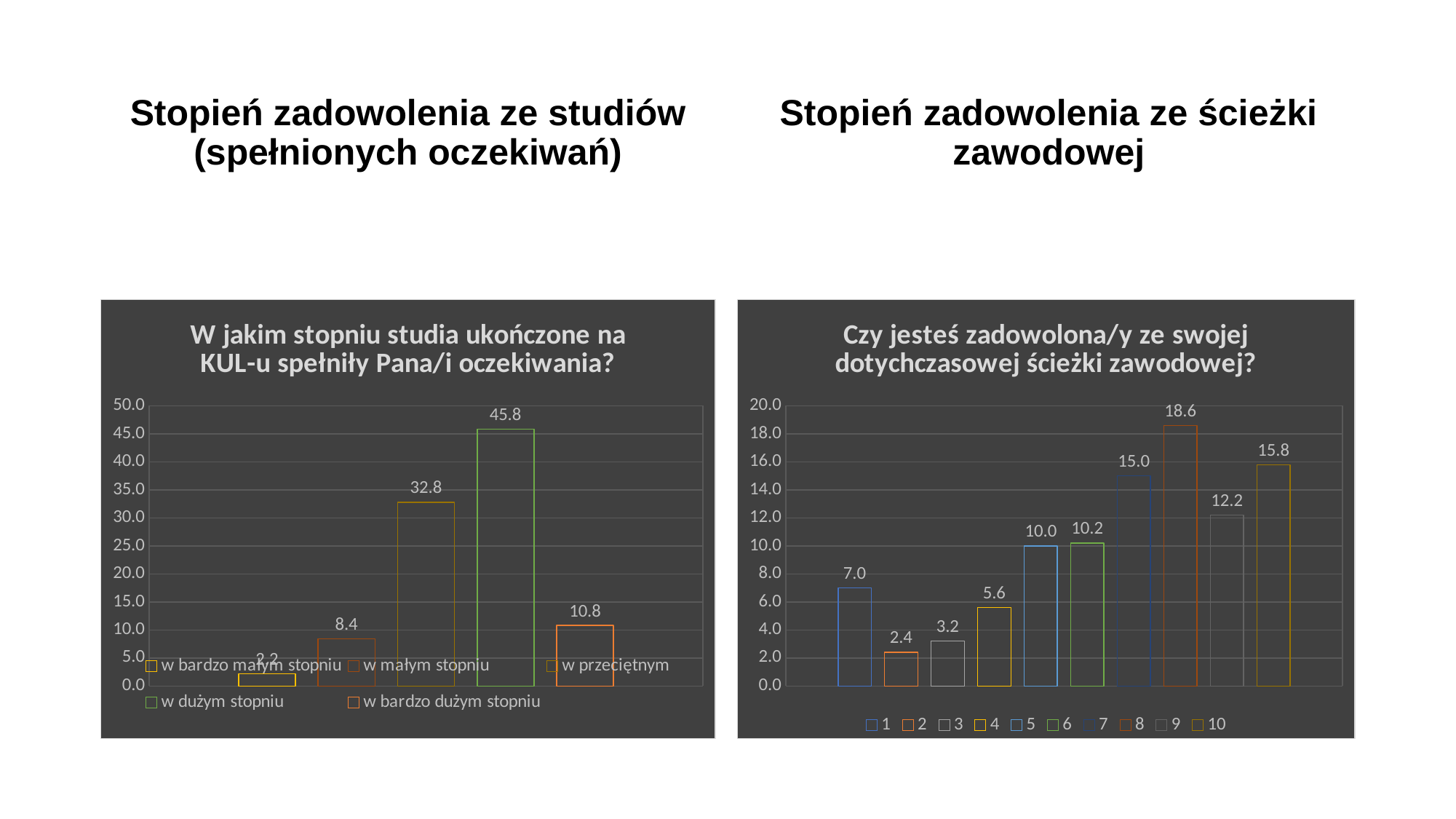
In the left chart (W jakim stopniu studia ukończone na KUL-u spełniły Pana/i oczekiwania?), which category has the highest value? w dużym stopniu In the right chart (Czy jesteś zadowolona/y ze swojej dotychczasowej ścieżki zawodowej?), what is the difference between category 10 and category 9? 3.6 In the right chart (Czy jesteś zadowolona/y ze swojej dotychczasowej ścieżki zawodowej?), what is the value for category 1? 7.0 In the left chart (W jakim stopniu studia ukończone na KUL-u spełniły Pana/i oczekiwania?), what is the difference between "w dużym stopniu" and "w przeciętnym"? 13.0 In the right chart (Czy jesteś zadowolona/y ze swojej dotychczasowej ścieżki zawodowej?), how many categories are plotted? 10 In the left chart (W jakim stopniu studia ukończone na KUL-u spełniły Pana/i oczekiwania?), how many entries does the legend list? 5 In the left chart (W jakim stopniu studia ukończone na KUL-u spełniły Pana/i oczekiwania?), what is the value for "w dużym stopniu"? 45.8 In the right chart (Czy jesteś zadowolona/y ze swojej dotychczasowej ścieżki zawodowej?), what is the value for category 8? 18.6 In the left chart (W jakim stopniu studia ukończone na KUL-u spełniły Pana/i oczekiwania?), which is larger: "w małym stopniu" or "w bardzo dużym stopniu"? w bardzo dużym stopniu In the right chart (Czy jesteś zadowolona/y ze swojej dotychczasowej ścieżki zawodowej?), which category has the lowest value? 2 What kind of chart is the right chart (Czy jesteś zadowolona/y ze swojej dotychczasowej ścieżki zawodowej?)? bar chart In the left chart (W jakim stopniu studia ukończone na KUL-u spełniły Pana/i oczekiwania?), what is the value for "w przeciętnym"? 32.8